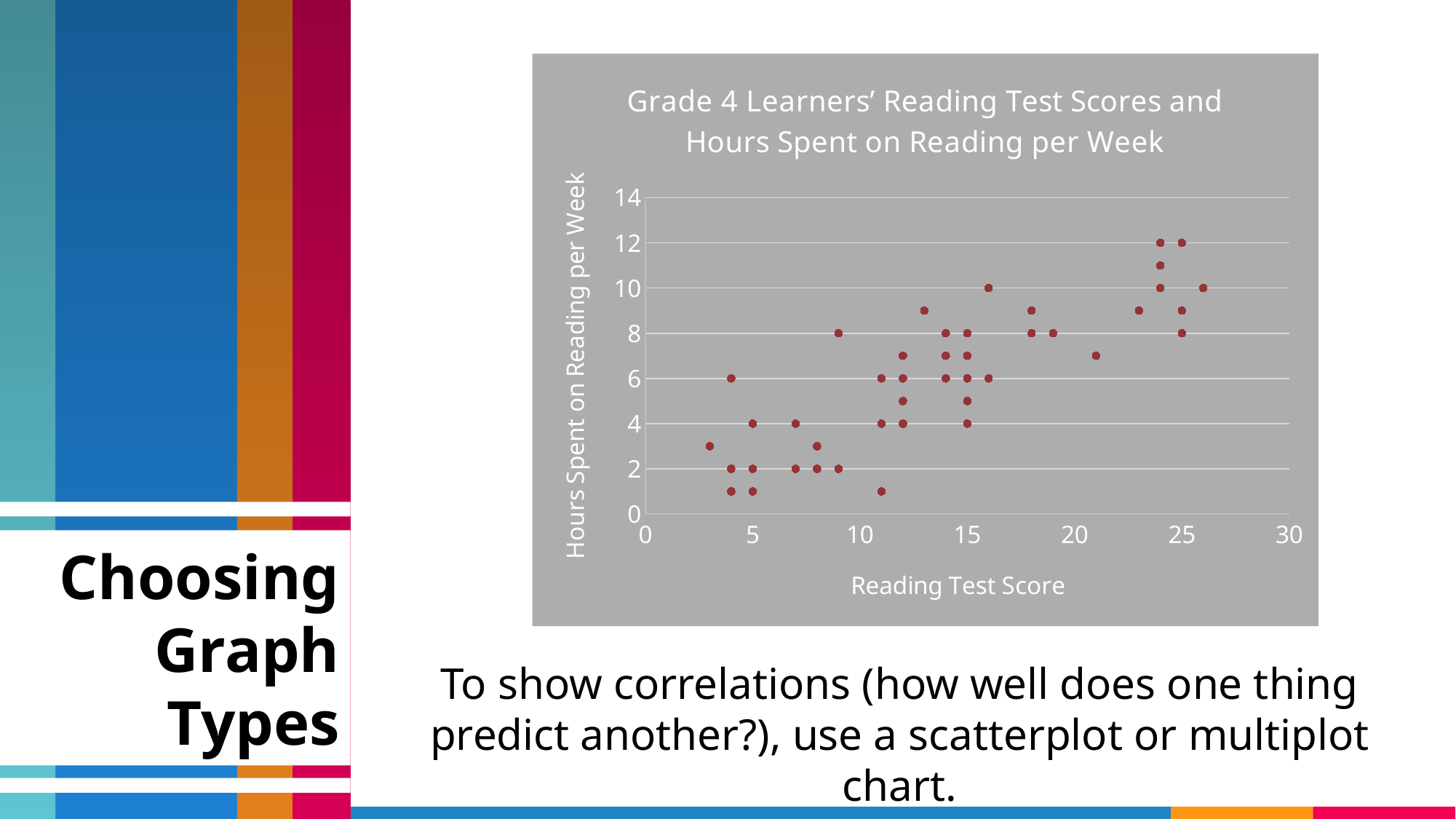
What is the title of the chart? Grade 4 Learners' Reading Test Scores and Hours Spent on Reading per Week As Reading Test Score increases along the x axis, do the hours spent on reading generally rise or fall? Rise Is the lowest hours-per-week value plotted on the chart greater or less than 2? less What is the label on the vertical axis of the chart? Hours Spent on Reading per Week Does the chart show a positive or negative relationship between Reading Test Score and Hours Spent on Reading per Week? Positive Is the highest Reading Test Score plotted on the chart greater or less than 30? less What kind of chart is shown on the slide? Scatter plot What is the highest number of hours spent on reading per week shown by any point on the chart? 12 Is the highest hours-per-week value plotted on the chart greater or less than 10? greater